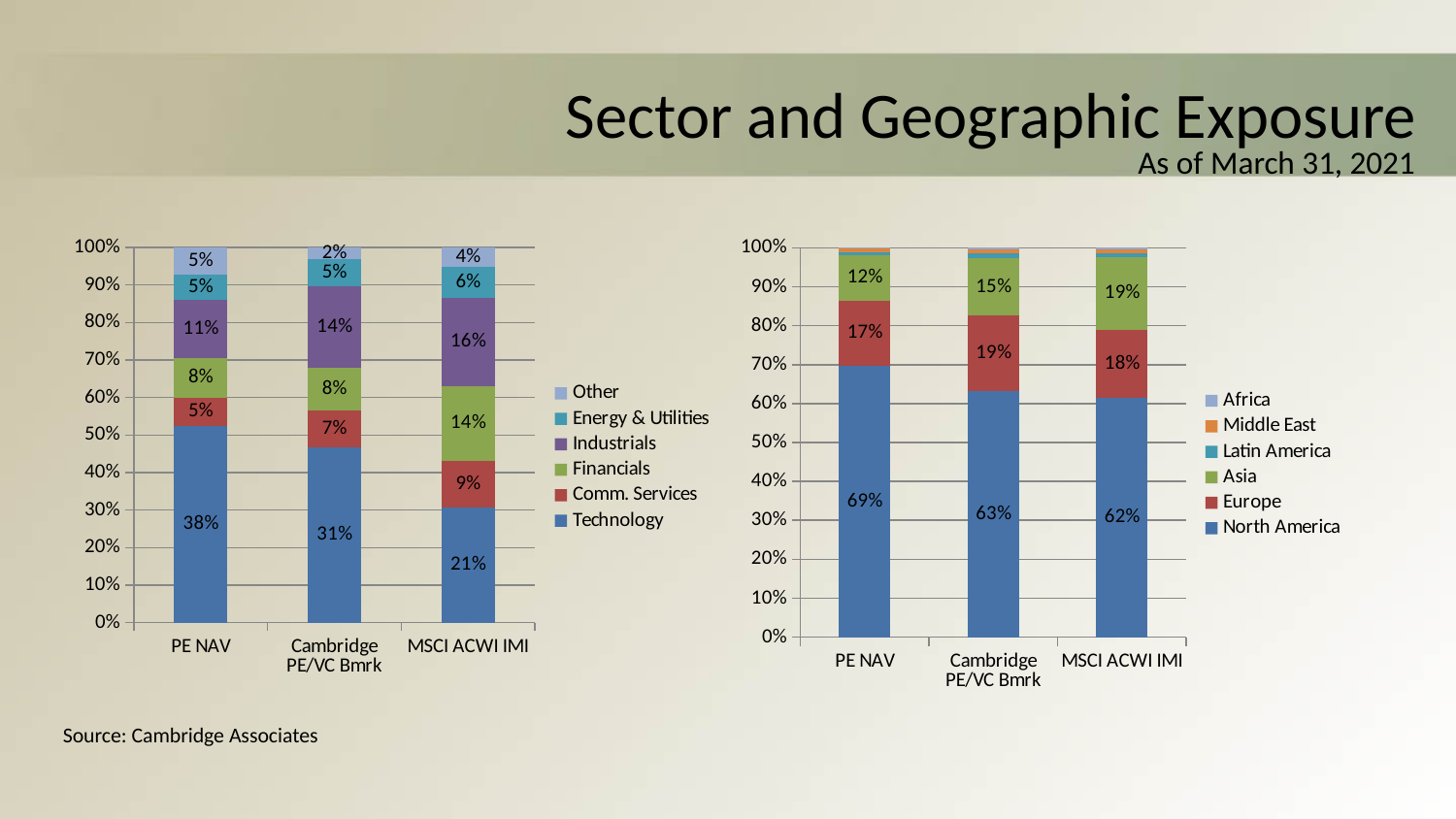
In the right chart, is the Europe value for PE NAV larger or smaller than the Europe value for Cambridge PE/VC Bmrk? smaller In the left chart, how many series does the legend list? 6 What kind of chart is the right chart? Stacked bar chart In the left chart, which category has the highest Technology value? PE NAV In the right chart, what is the North America value for Cambridge PE/VC Bmrk? 63% In the right chart, which category has the lowest North America value? MSCI ACWI IMI In the left chart, what is the Industrials value for MSCI ACWI IMI? 16% In the right chart, what is the Asia value for MSCI ACWI IMI? 19% In the left chart, what is the difference between the Financials values for MSCI ACWI IMI and PE NAV? 6% In the left chart, what is the Technology value for PE NAV? 38% In the left chart, what is the Comm. Services value for Cambridge PE/VC Bmrk? 7% In the right chart, how many categories are shown on the x axis? 3